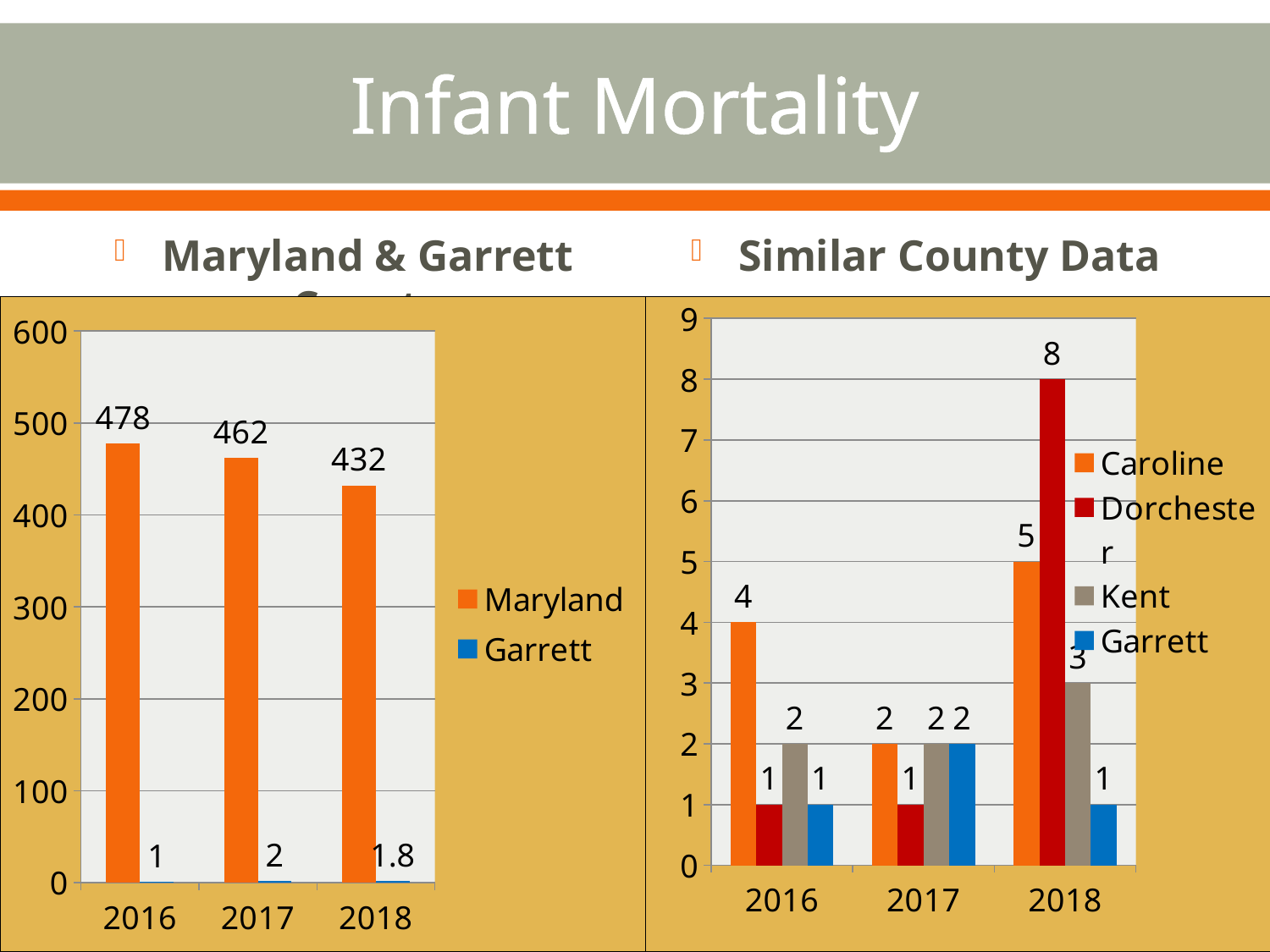
In the Similar County Data chart, what is the value for Caroline in 2016? 4 In the Similar County Data chart, what is the value for Dorchester in 2018? 8 In the left chart, what is the difference between the Maryland values for 2016 and 2018? 46 How many series does the legend of the Similar County Data chart list? 4 In the left chart, which year has the lowest Maryland value? 2018 How many series does the legend of the left chart list? 2 In the Similar County Data chart, which county has the highest value in 2018? Dorchester In the left chart, what is the value for Maryland in 2016? 478 In the left chart, do the Maryland values rise or fall from 2016 to 2018? fall In the Similar County Data chart, which is larger in 2018: Caroline or Kent? Caroline In the left chart, what is the value for Garrett in 2018? 1.8 What kind of chart is the Similar County Data chart? bar chart